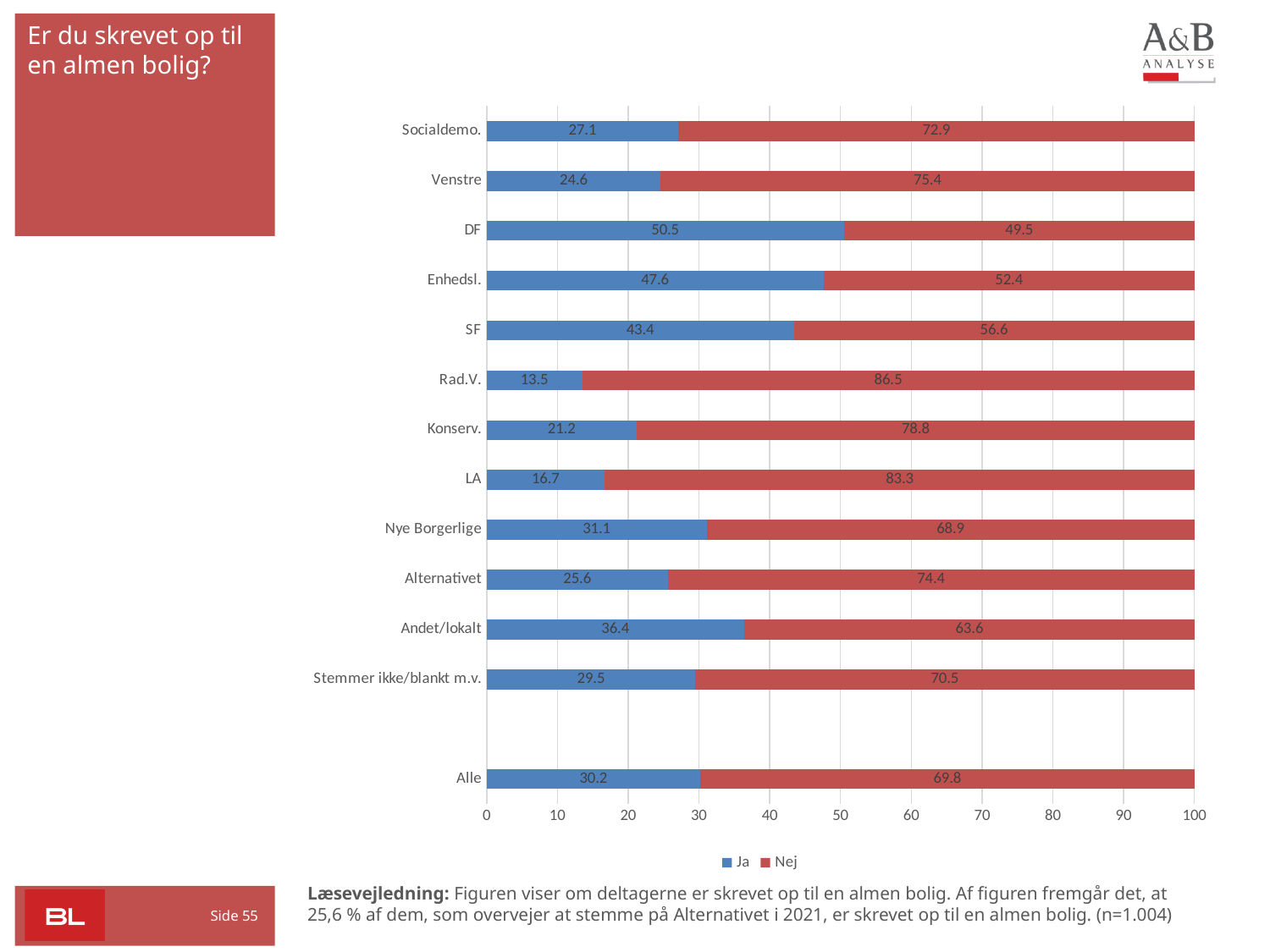
What is the 'Nej' value for Rad.V.? 86.5 What is the 'Ja' value for Alle? 30.2 Which has a larger 'Ja' value, Enhedsl. or SF? Enhedsl. What is the total of the stacked bar for Venstre? 100 Which category has the highest 'Ja' value? DF What is the 'Ja' value for DF? 50.5 What kind of chart is shown on the slide? Stacked bar chart What is the difference between the 'Nej' value for LA and the 'Nej' value for Konserv.? 4.5 Which category has the lowest 'Ja' value? Rad.V. What are the two series named in the legend? Ja and Nej How many series does the legend list? 2 How many categories are shown on the y axis? 13